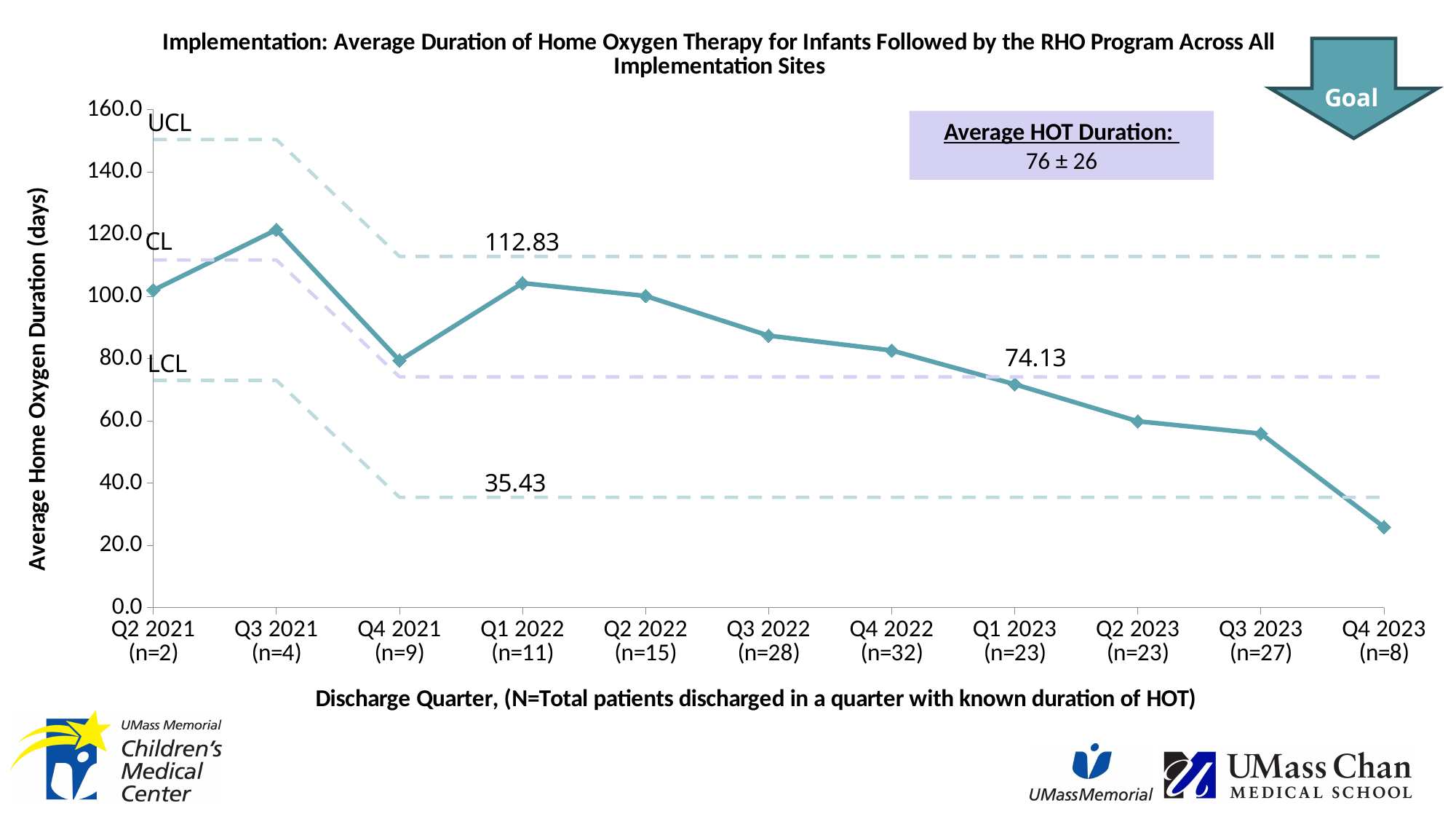
What Average HOT Duration is stated in the box on the slide? 76 ± 26 What is the value of the lower control limit (LCL) labelled on the chart from Q4 2021 onward? 35.43 How many discharge quarters are plotted on the x axis? 11 Which discharge quarter has the highest average home oxygen duration? Q3 2021 What is the value of the center line (CL) labelled on the chart from Q4 2021 onward? 74.13 Is the average home oxygen duration for Q4 2023 greater or less than 40? less What kind of chart is shown on the slide? line chart Which has a higher average home oxygen duration, Q4 2021 or Q1 2022? Q1 2022 Which discharge quarter has the lowest average home oxygen duration? Q4 2023 What is the value of the upper control limit (UCL) labelled on the chart from Q4 2021 onward? 112.83 Is the average home oxygen duration for Q3 2021 greater or less than 100? greater From Q1 2022 to Q4 2023, does the average home oxygen duration rise or fall? fall